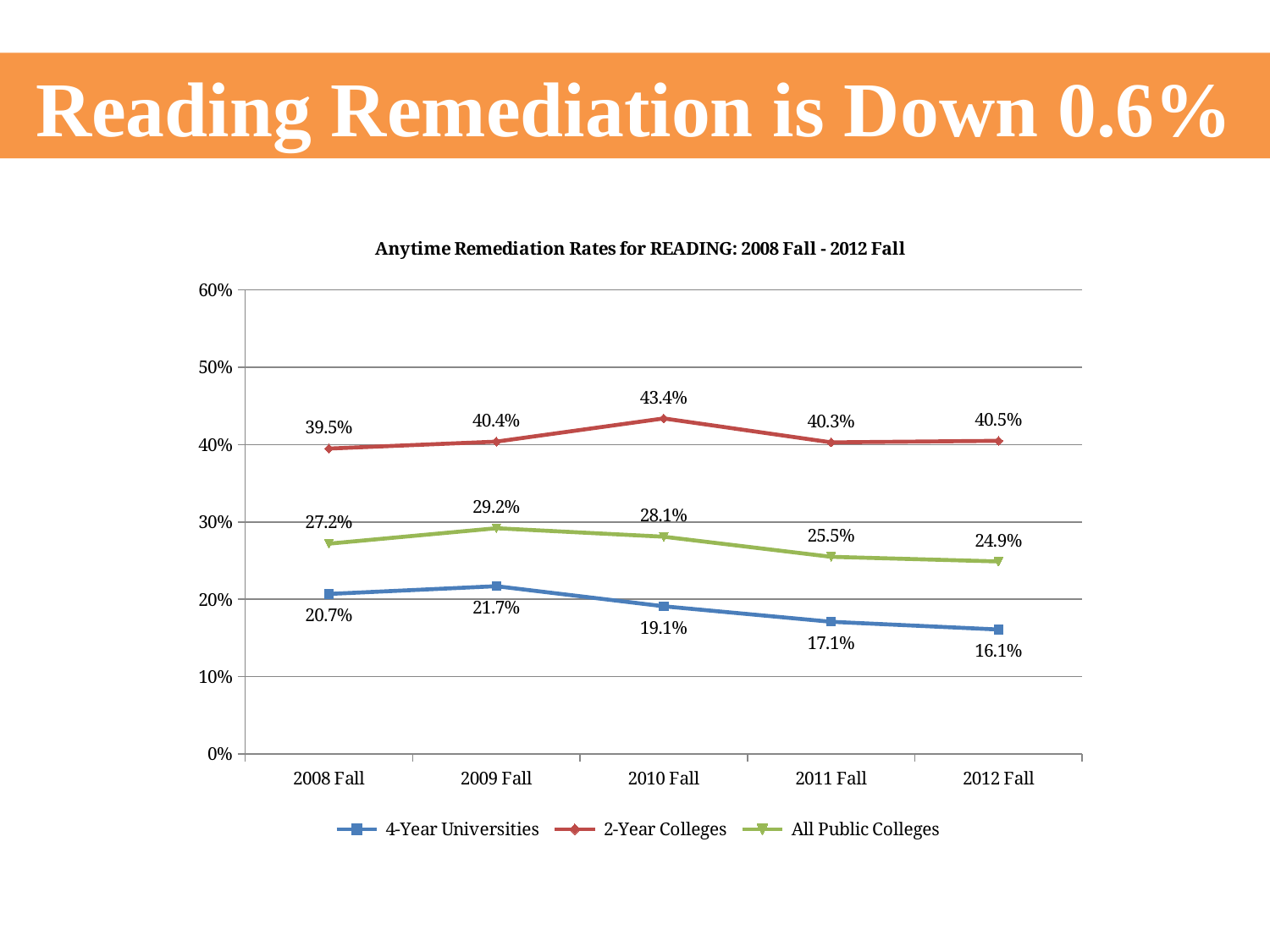
Does the 4-Year Universities rate rise or fall from 2009 Fall to 2012 Fall? Fall What kind of chart is shown on the slide? Line chart In which year is the 4-Year Universities rate lowest? 2012 Fall What is the All Public Colleges remediation rate for 2009 Fall? 29.2% How many time points are shown on the x axis? 5 What is the difference between the All Public Colleges rate in 2011 Fall and 2012 Fall? 0.6% Which is larger in 2008 Fall: the 2-Year Colleges rate or the All Public Colleges rate? 2-Year Colleges In which year is the 2-Year Colleges rate highest? 2010 Fall What is the 2-Year Colleges remediation rate for 2010 Fall? 43.4% Is the 4-Year Universities value for 2009 Fall greater or less than 20%? greater What is the 4-Year Universities remediation rate for 2012 Fall? 16.1% How many series does the legend list? 3